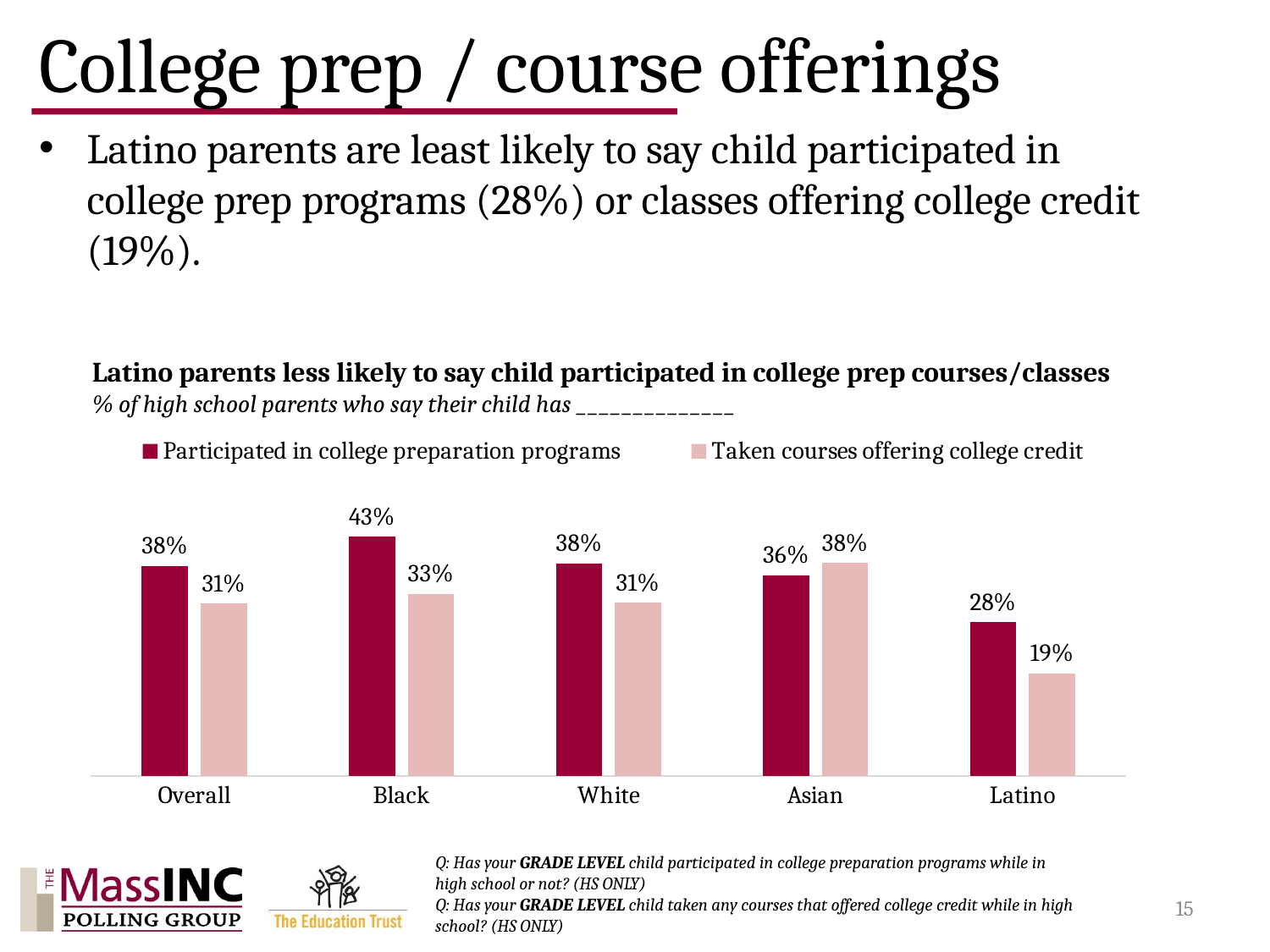
How many groups are shown on the x axis of the chart? 5 For Asian parents, which is larger: 'Participated in college preparation programs' or 'Taken courses offering college credit'? Taken courses offering college credit How many series does the chart legend list? 2 What kind of chart is shown on the slide? Bar chart Which group has the lowest value for 'Taken courses offering college credit'? Latino What percentage of Latino parents say their child has taken courses offering college credit? 19% What is the value for Asian parents for 'Taken courses offering college credit'? 38% What is the difference between the Overall values for the two series? 7 percentage points What is the difference between the Black and Latino values for 'Participated in college preparation programs'? 15 percentage points What is the title of the chart? Latino parents less likely to say child participated in college prep courses/classes Which group has the highest value for 'Participated in college preparation programs'? Black What percentage of Black parents say their child participated in college preparation programs? 43%